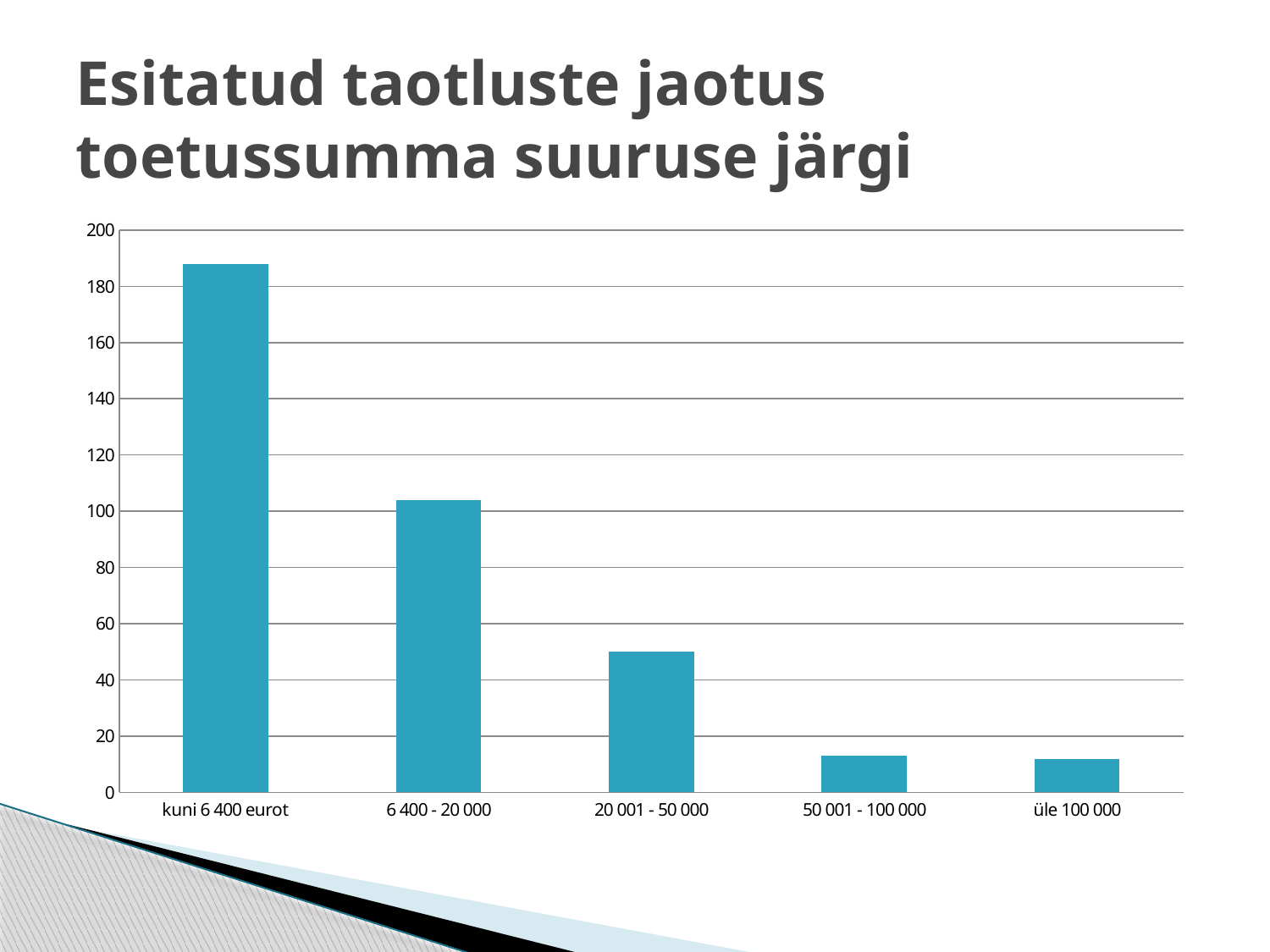
Which is larger, the value for "6 400 - 20 000" or the value for "20 001 - 50 000"? 6 400 - 20 000 Is the value for "kuni 6 400 eurot" greater or less than 180? greater Which category has the highest bar? kuni 6 400 eurot Is the value for "6 400 - 20 000" greater or less than 100? greater What is the highest value shown on the y axis of the chart? 200 How many categories are shown on the x axis of the chart? 5 What kind of chart is shown on the slide? bar chart Is the value for "20 001 - 50 000" greater or less than 60? less Do the values rise or fall moving from left to right along the x axis? fall What is the title of the slide containing the chart? Esitatud taotluste jaotus toetussumma suuruse järgi